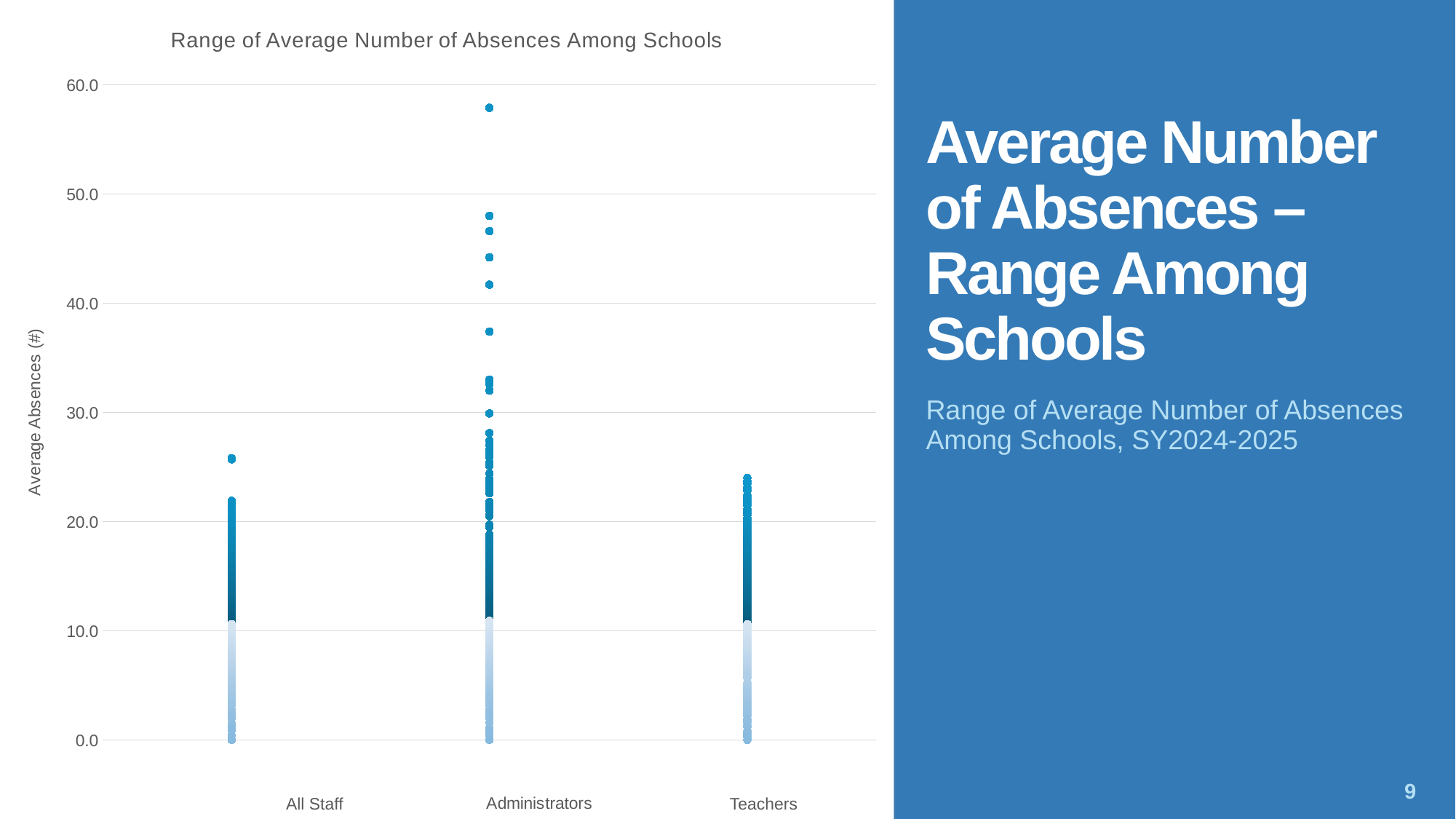
What is the label on the y axis? Average Absences (#) Is the highest value for All Staff greater or less than 30? less How many categories are shown along the x axis? 3 Is the highest value for Teachers greater or less than 20? greater Which has a higher maximum plotted value, Administrators or Teachers? Administrators What is the title of the chart? Range of Average Number of Absences Among Schools Which category has the highest plotted value? Administrators Is the highest value for Administrators greater or less than 50? greater What kind of chart is shown on the slide? Scatter (dot) plot